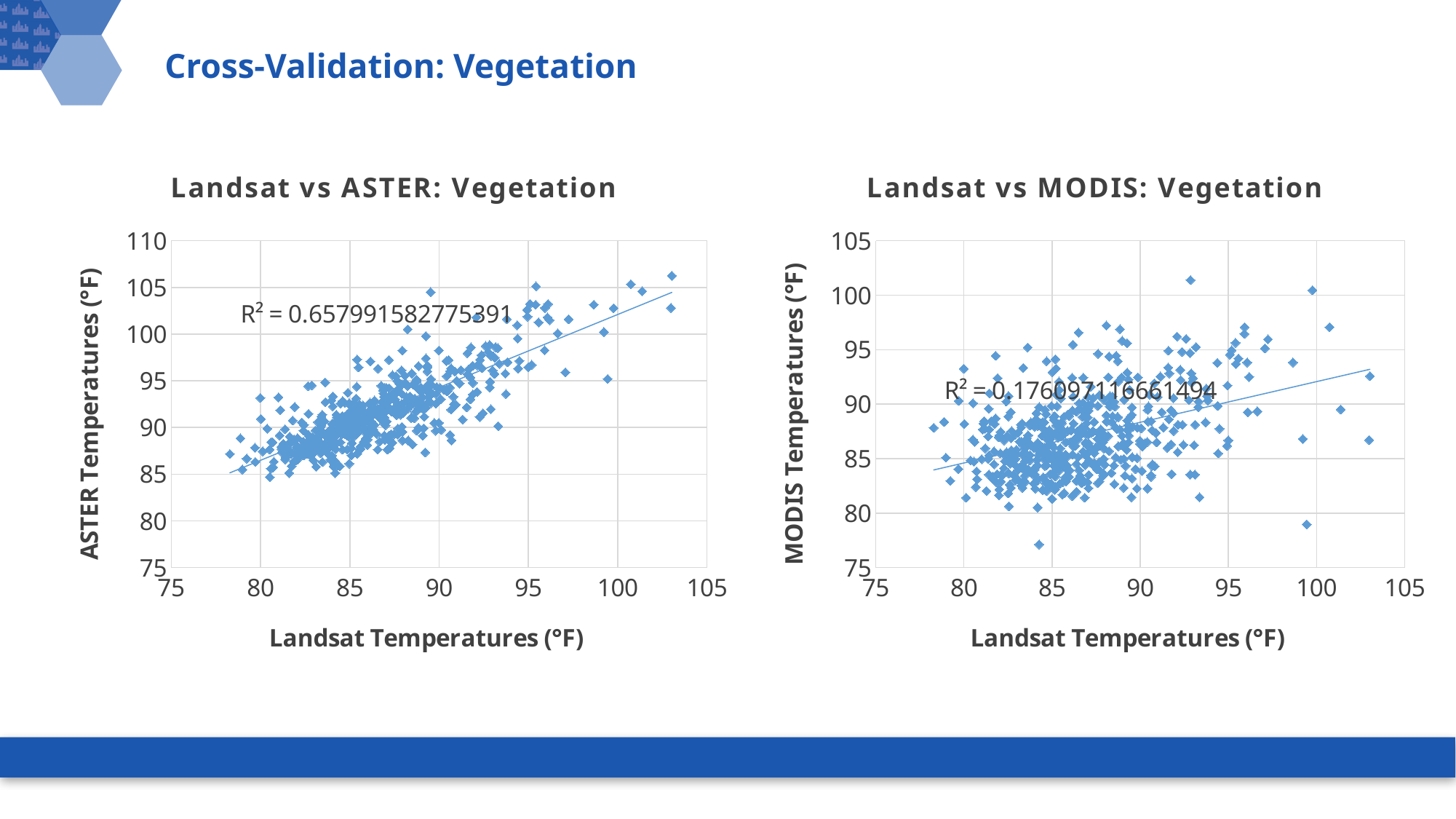
In the 'Landsat vs MODIS: Vegetation' chart, is the lowest MODIS temperature plotted greater or less than 80? less In the 'Landsat vs MODIS: Vegetation' chart, is the highest MODIS temperature plotted greater or less than 100? greater Which chart shows the higher R² value, 'Landsat vs ASTER: Vegetation' or 'Landsat vs MODIS: Vegetation'? Landsat vs ASTER: Vegetation What is the x-axis label of the 'Landsat vs MODIS: Vegetation' chart? Landsat Temperatures (°F) What kind of chart is the 'Landsat vs ASTER: Vegetation' chart? scatter chart What is the y-axis label of the 'Landsat vs ASTER: Vegetation' chart? ASTER Temperatures (°F) What kind of chart is the 'Landsat vs MODIS: Vegetation' chart? scatter chart What is the difference between the R² values printed on the 'Landsat vs ASTER: Vegetation' chart and the 'Landsat vs MODIS: Vegetation' chart? 0.481894466113897 In the 'Landsat vs MODIS: Vegetation' chart, does the fitted trend line rise or fall along the x axis? rise In the 'Landsat vs ASTER: Vegetation' chart, do the ASTER temperatures generally rise or fall as Landsat temperatures increase along the x axis? rise In the 'Landsat vs MODIS: Vegetation' chart, what R² value is printed on the chart? R² = 0.176097116661494 In the 'Landsat vs ASTER: Vegetation' chart, what R² value is printed on the chart? R² = 0.657991582775391